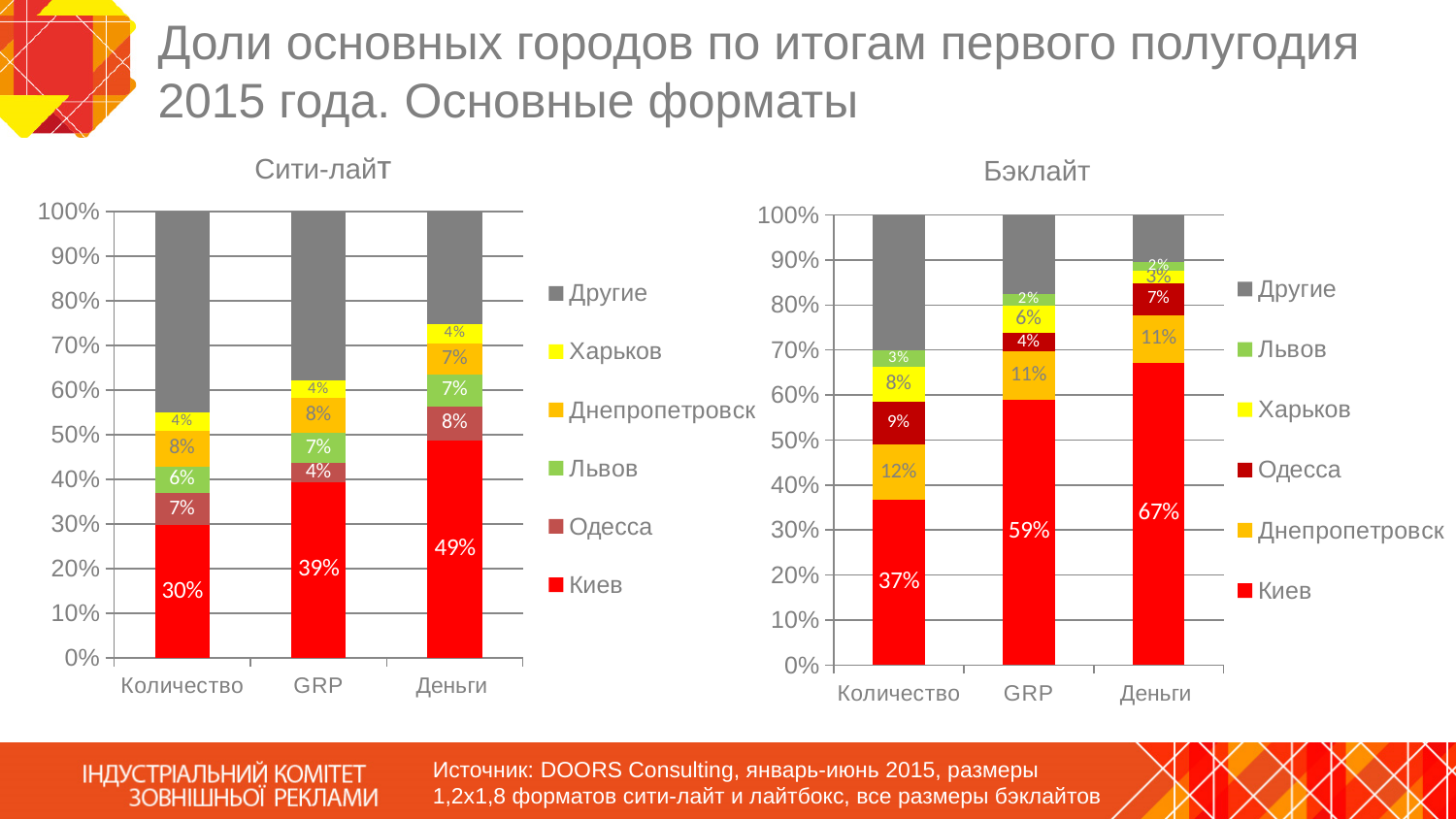
In the Сити-лайт chart, which category has the highest value for Киев? Деньги In the Сити-лайт chart, what is the value for Киев in the Деньги bar? 49% How many series does the legend of the Сити-лайт chart list? 6 In the Бэклайт chart, what is the difference between the Киев values for Деньги and Количество? 30% In the Сити-лайт chart, is the value for Другие in the Количество bar greater or less than 40%? greater In the Сити-лайт chart, what is the value for Одесса in the Количество bar? 7% In the Бэклайт chart, what is the value for Днепропетровск in the Количество bar? 12% What kind of chart is the Бэклайт chart? Stacked bar chart How many categories are shown on the x axis of the Бэклайт chart? 3 In the Бэклайт chart, which category has the lowest value for Киев? Количество In the Бэклайт chart, what is the value for Киев in the GRP bar? 59% In the Сити-лайт chart, which is larger: the Киев value for GRP or for Количество? GRP